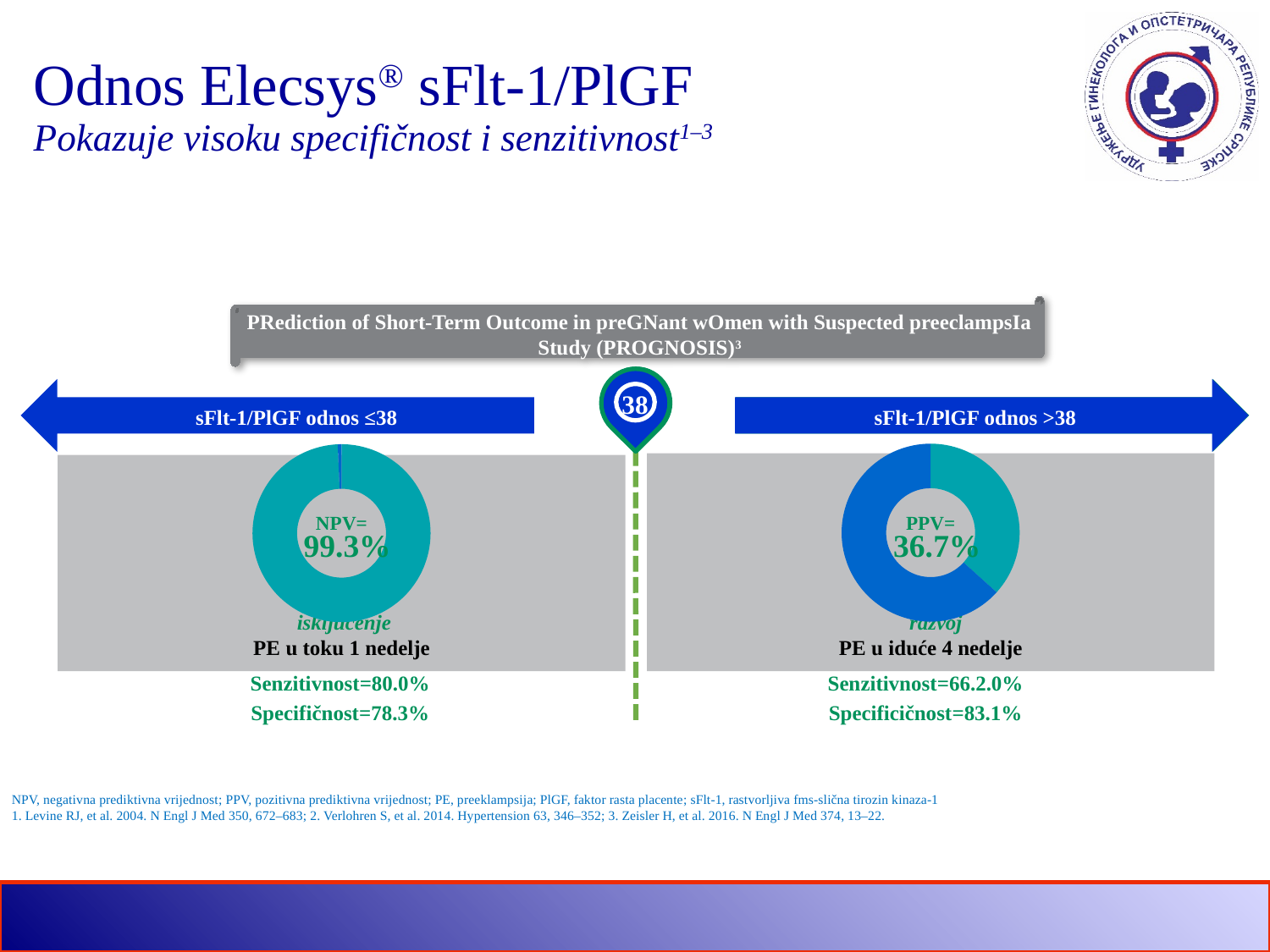
What kind of chart is used to display the NPV and PPV values on the slide? Donut (pie) chart What is the difference between the NPV (99.3%) in the left chart and the PPV (36.7%) in the right chart? 62.6 percentage points Is the NPV value in the left donut chart greater or less than 90%? greater Which value is larger, the NPV in the left chart or the PPV in the right chart? NPV (99.3%) How many donut charts are shown on the slide? 2 In the right donut chart (sFlt-1/PlGF odnos >38), what is the PPV value shown in the centre? 36.7% Is the PPV value in the right donut chart greater or less than 50%? less In the left donut chart (sFlt-1/PlGF odnos ≤38), what is the NPV value shown in the centre? 99.3% What is the heading above the left donut chart? sFlt-1/PlGF odnos ≤38 In the right donut chart, what colour is the larger slice? Blue Which chart has the larger teal slice, the left (NPV) chart or the right (PPV) chart? The left (NPV) chart